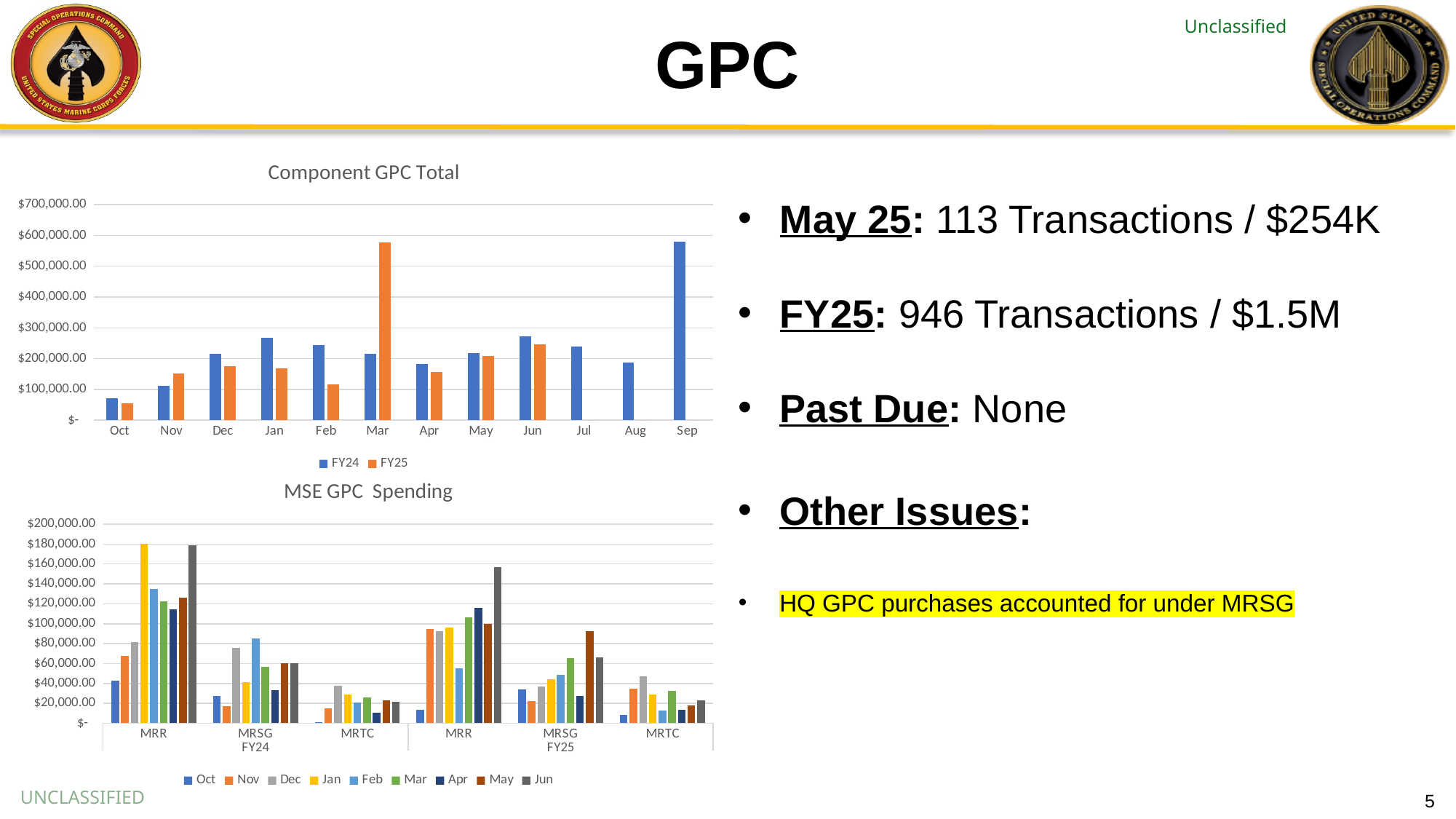
In the 'Component GPC Total' chart, which is larger for Feb: the FY24 value or the FY25 value? FY24 In the 'Component GPC Total' chart, how many months have an FY25 bar? 9 In the 'Component GPC Total' chart, is the FY25 value for Mar greater or less than $500,000.00? greater In the 'Component GPC Total' chart, which month has the highest FY24 value? Sep How many series does the legend of the 'MSE GPC Spending' chart list? 9 How many series does the legend of the 'Component GPC Total' chart list? 2 In the 'MSE GPC Spending' chart, is the Jan value for MRR in FY24 greater or less than $160,000.00? greater In the 'Component GPC Total' chart, is the FY25 value for Feb greater or less than $200,000.00? less In the 'Component GPC Total' chart, which month has the highest FY25 value? Mar In the 'Component GPC Total' chart, which month has the lowest FY25 value? Oct What type of chart is the 'Component GPC Total' chart? bar chart